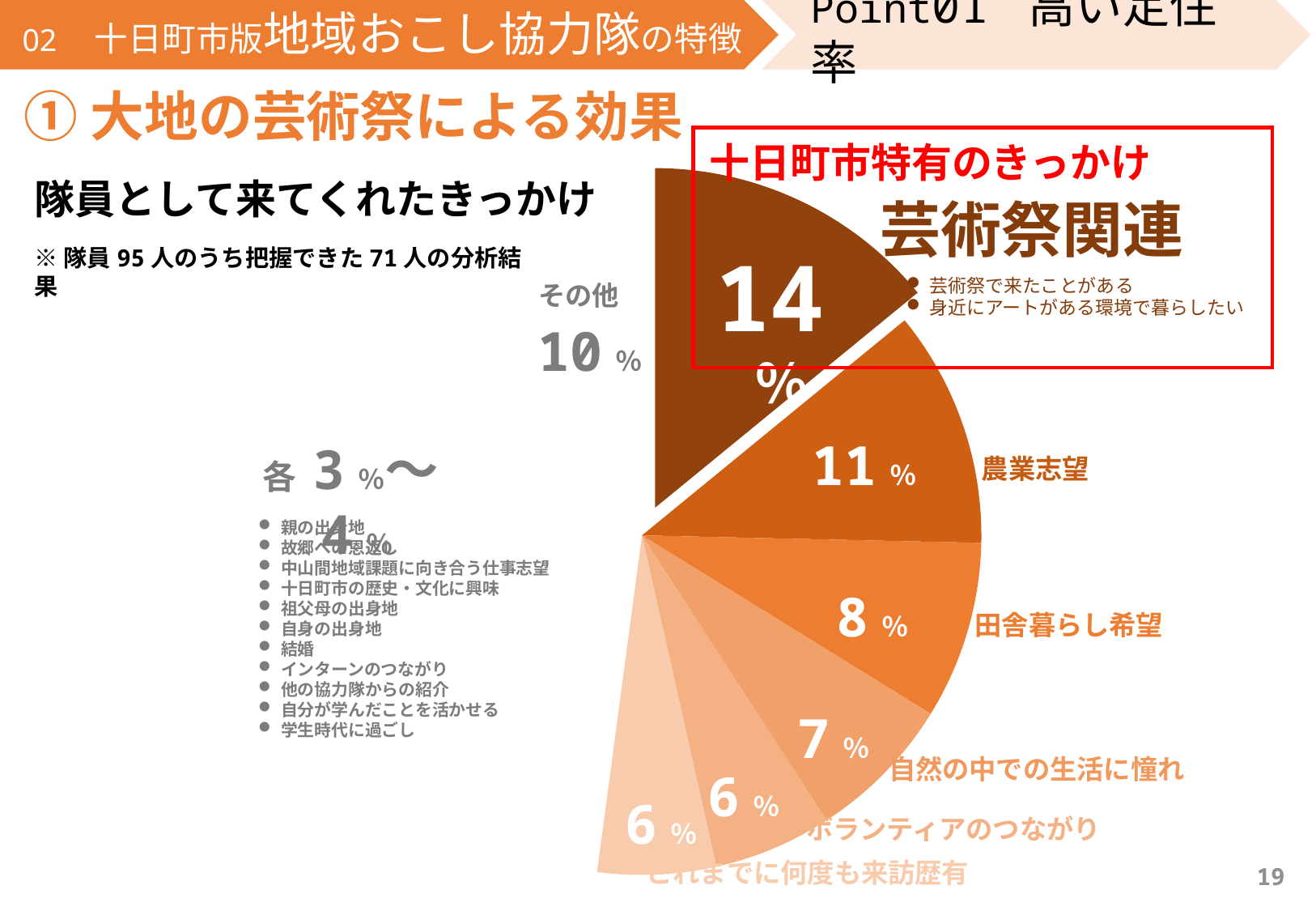
What percentage of the pie chart is ボランティアのつながり? 6% Which category has the largest share of the pie chart? 芸術祭関連 What is the difference in percentage points between 芸術祭関連 and 農業志望? 3 Which is larger in the pie chart, 農業志望 or 田舎暮らし希望? 農業志望 What percentage of the pie chart is その他? 10% What percentage of the pie chart is 自然の中での生活に憧れ? 7% What percentage of the pie chart is 田舎暮らし希望? 8% What percentage of the pie chart is 農業志望? 11% What percentage of the pie chart is 芸術祭関連? 14% What is the title of the pie chart? 隊員として来てくれたきっかけ What kind of chart is shown on the slide? pie chart What is the difference in percentage points between その他 and 田舎暮らし希望? 2